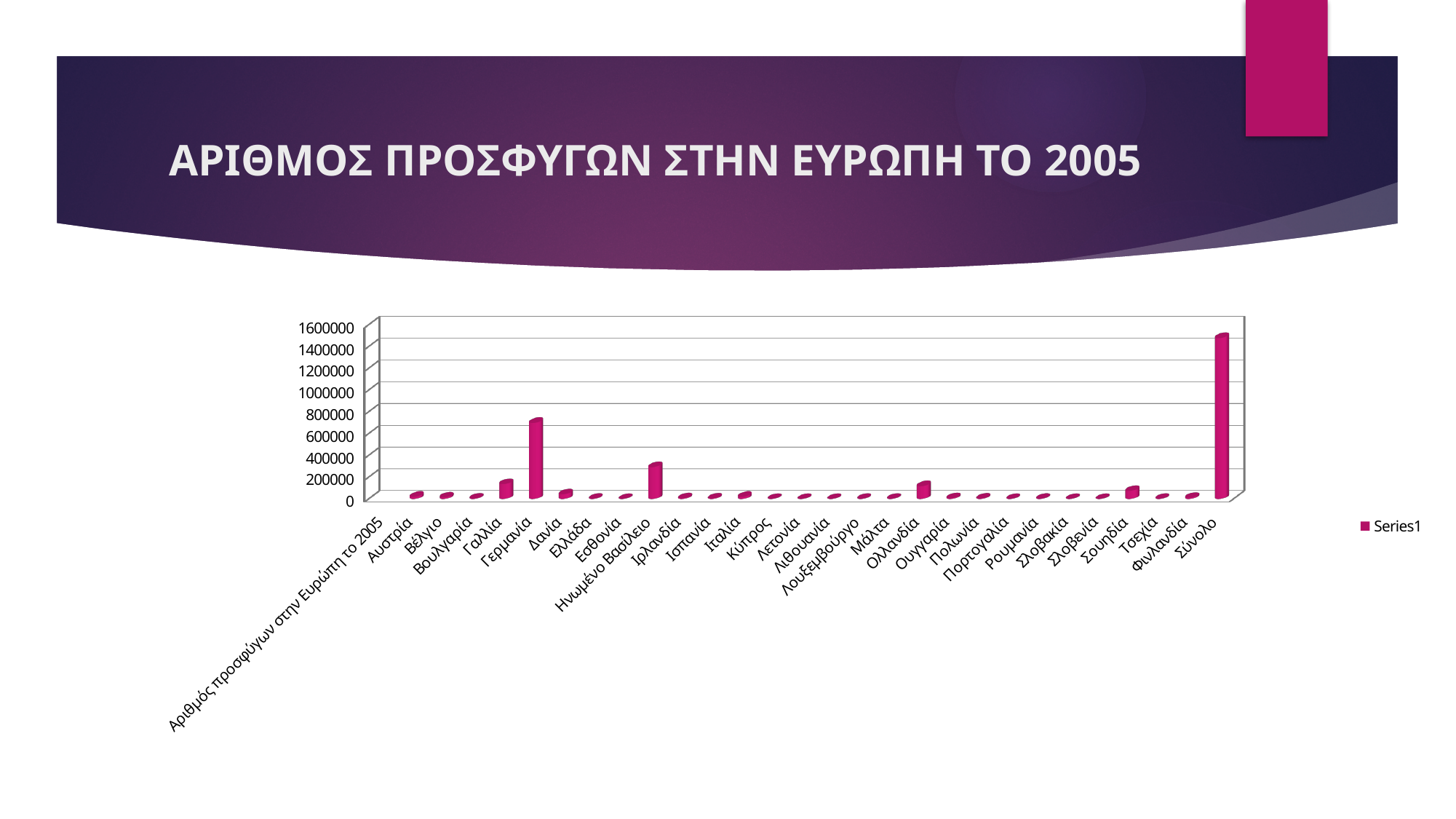
Is the value for Ηνωμένο Βασίλειο greater or less than 400000? less Is the value for Γερμανία greater or less than 800000? less What kind of chart is shown on the slide? bar chart Which category has the highest bar in the chart? Σύνολο What is the title of the slide containing the chart? ΑΡΙΘΜΟΣ ΠΡΟΣΦΥΓΩΝ ΣΤΗΝ ΕΥΡΩΠΗ ΤΟ 2005 Is the value for Σύνολο greater or less than 1400000? greater Which is larger, the value for Γαλλία or the value for Σουηδία? Γαλλία How many series does the legend list? 1 What is the name of the series shown in the legend? Series1 Excluding Σύνολο, which country has the highest bar? Γερμανία Which is larger, the value for Γερμανία or the value for Ηνωμένο Βασίλειο? Γερμανία